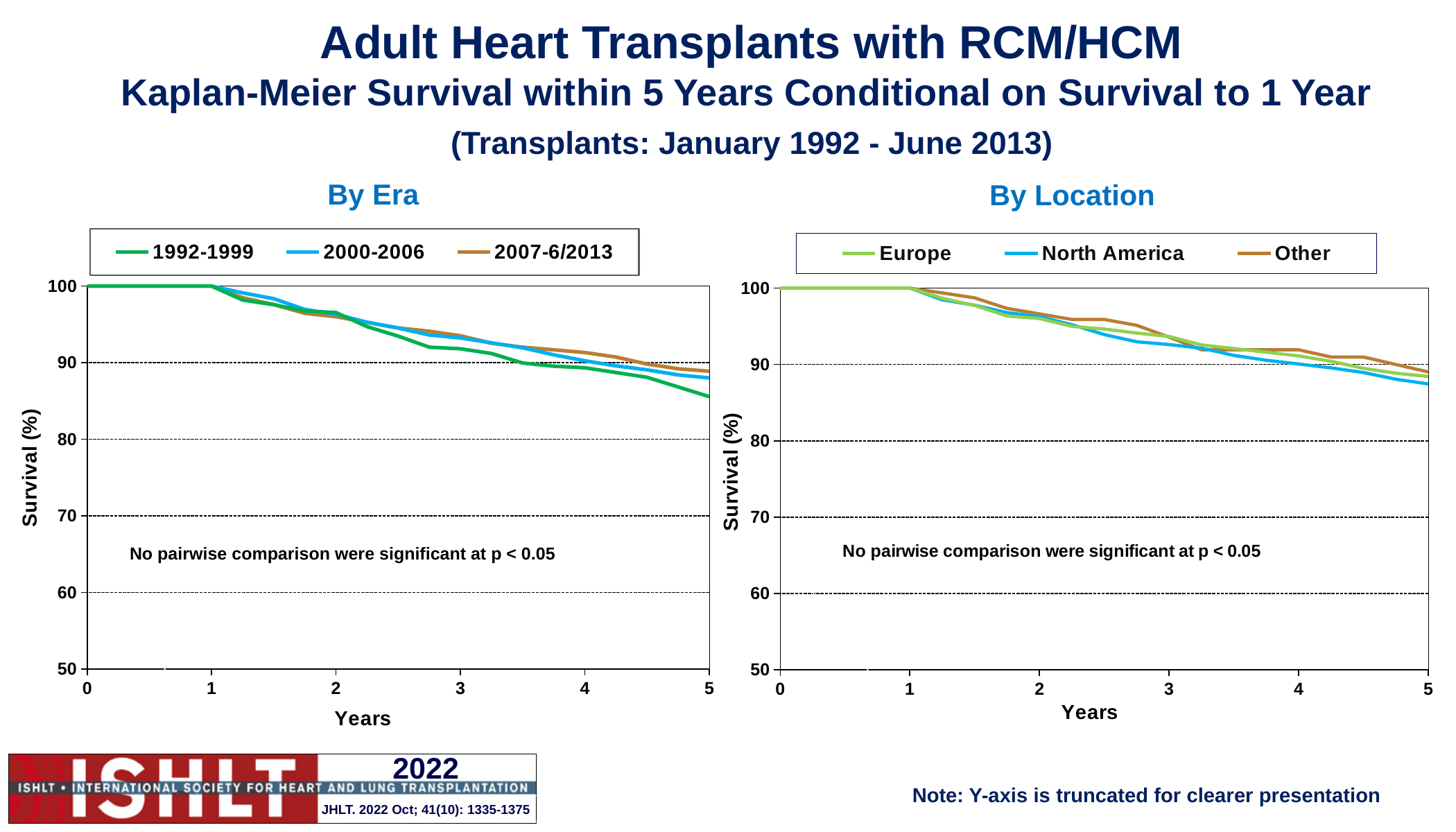
What kind of chart is the 'By Era' chart? line chart In the 'By Era' chart, is the survival for 1992-1999 at year 3 greater or less than 90? greater In the 'By Era' chart, is the survival for 1992-1999 at year 5 greater or less than 90? less In the 'By Location' chart, do the survival values rise or fall as years increase from 1 to 5? fall How many series does the legend of the 'By Location' chart list? 3 In the 'By Location' chart, is the survival for Other at year 4 greater or less than 90? greater In the 'By Era' chart, which series has the lowest survival at year 5? 1992-1999 How many series does the legend of the 'By Era' chart list? 3 In the 'By Era' chart, at year 4, which is larger: the survival for 2007-6/2013 or for 1992-1999? 2007-6/2013 What are the legend entries of the 'By Location' chart? Europe, North America, Other In the 'By Era' chart, do the survival values rise or fall as years increase from 1 to 5? fall